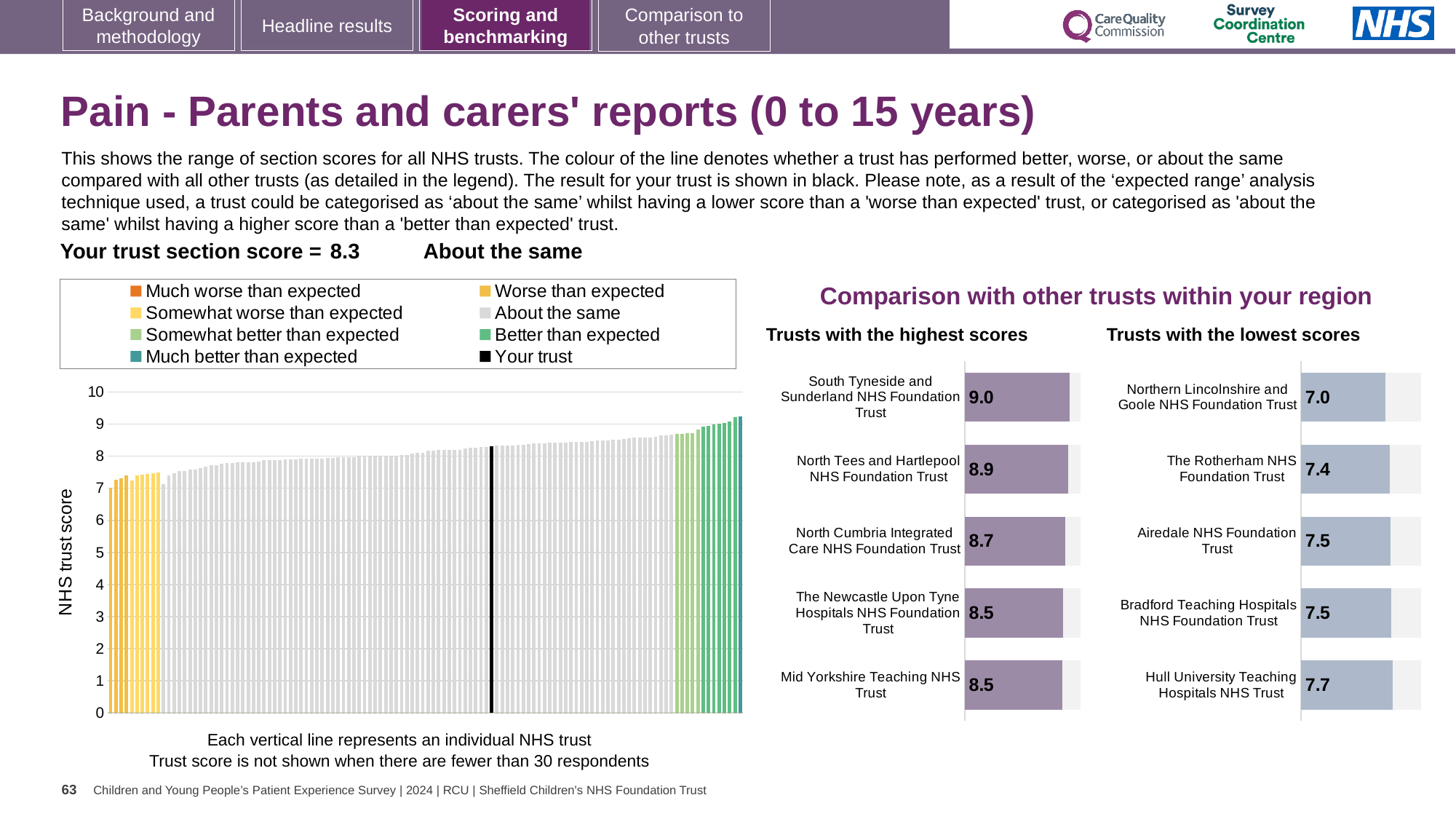
On the 'Trusts with the lowest scores' chart, which trust has the lowest score? Northern Lincolnshire and Goole NHS Foundation Trust On the 'Trusts with the highest scores' chart, what is the score for South Tyneside and Sunderland NHS Foundation Trust? 9.0 On the 'Trusts with the lowest scores' chart, what is the score for The Rotherham NHS Foundation Trust? 7.4 How many trusts are shown on the 'Trusts with the highest scores' chart? 5 On the 'Trusts with the lowest scores' chart, what is the difference between the scores of Hull University Teaching Hospitals NHS Trust and Northern Lincolnshire and Goole NHS Foundation Trust? 0.7 On the 'Trusts with the highest scores' chart, which trust has the highest score? South Tyneside and Sunderland NHS Foundation Trust On the NHS trust score chart on the left, is the value for your trust greater or less than 8? greater What kind of chart is the NHS trust score chart on the left of the slide? Bar chart How many entries does the legend of the NHS trust score chart on the left list? 8 On the 'Trusts with the lowest scores' chart, which has the larger score: Hull University Teaching Hospitals NHS Trust or Airedale NHS Foundation Trust? Hull University Teaching Hospitals NHS Trust On the 'Trusts with the highest scores' chart, what is the difference between the scores of South Tyneside and Sunderland NHS Foundation Trust and North Cumbria Integrated Care NHS Foundation Trust? 0.3 On the NHS trust score chart on the left, do the values rise or fall from left to right? Rise